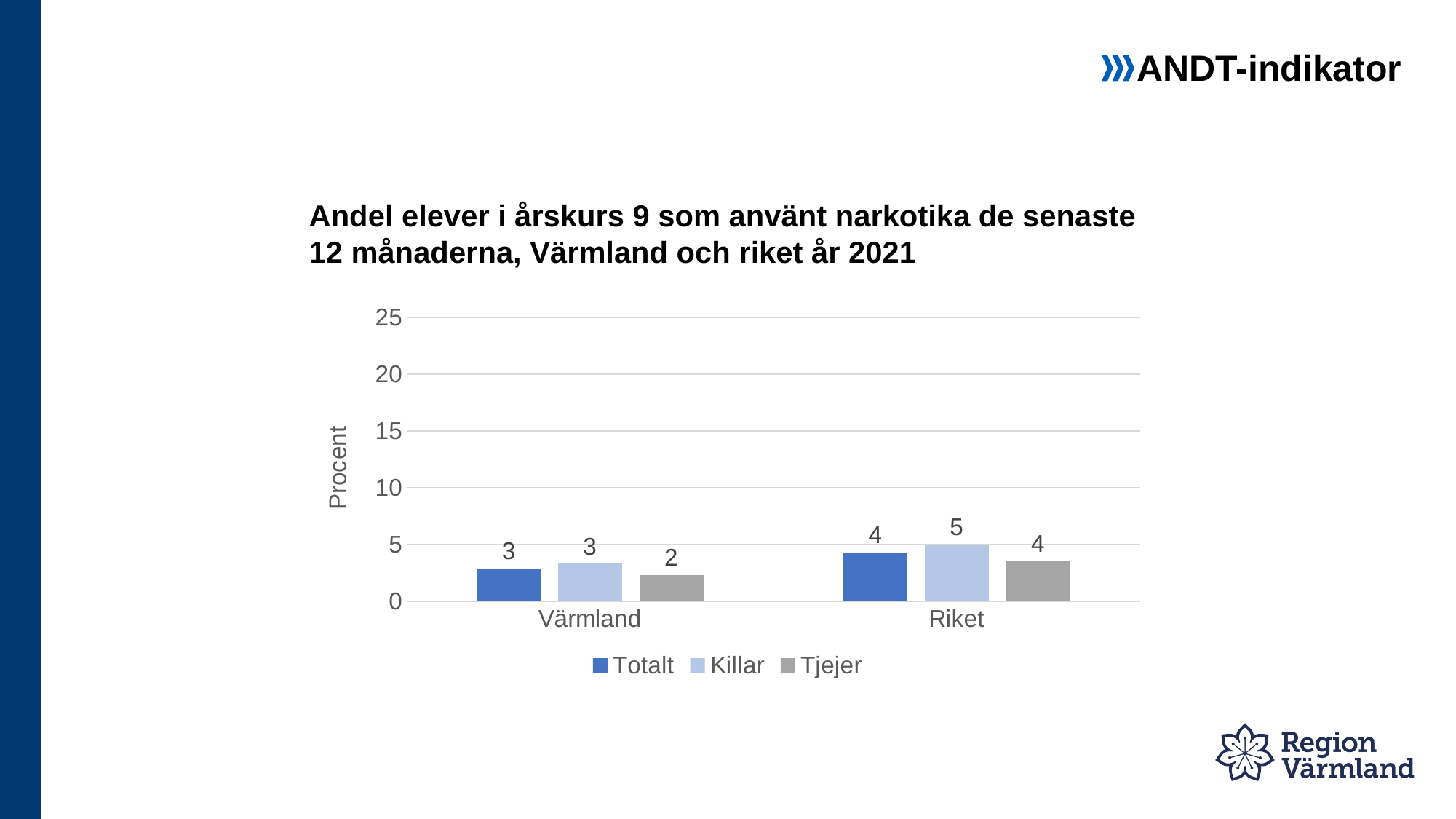
What is the difference between the Killar value for Riket and the Killar value for Värmland? 2 Is the value for Totalt in Värmland greater or less than 10? less What is the value for Totalt in Riket? 4 What is the label of the vertical axis? Procent How many series does the legend list? 3 What is the value for Killar in Riket? 5 What is the value for Tjejer in Värmland? 2 What is the value for Totalt in Värmland? 3 Which series has the lowest value in Värmland? Tjejer Which series has the highest value in Riket? Killar Which is larger, the Tjejer value for Riket or the Tjejer value for Värmland? Riket What kind of chart is shown on the slide? bar chart